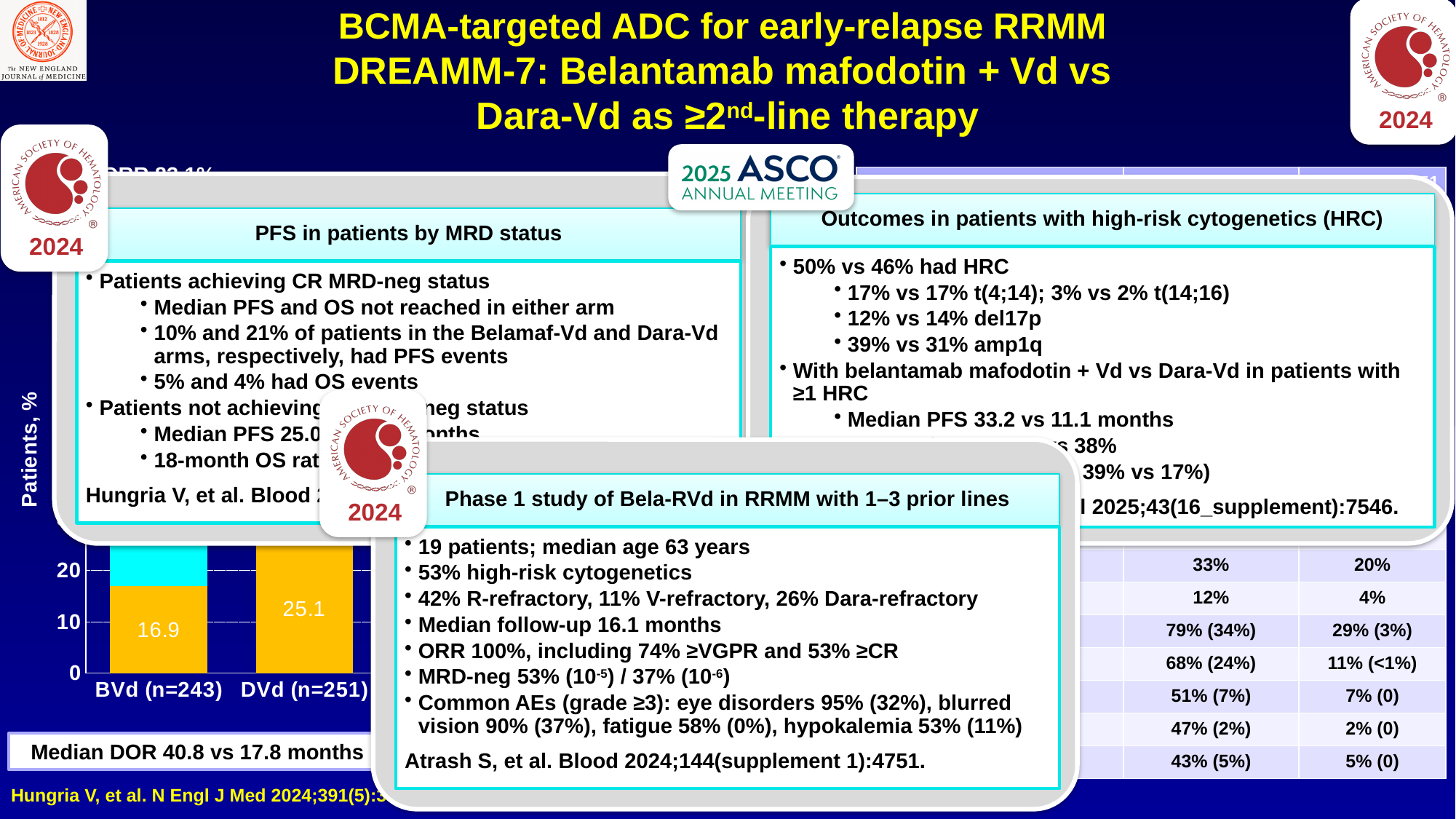
In the bar chart at the bottom left, what value is labelled on the yellow segment of the BVd (n=243) bar? 16.9 How many category bars are visible in the bar chart at the bottom left of the slide? 2 In the bar chart at the bottom left, is the labelled yellow segment value for BVd (n=243) greater or less than 10? greater In the bar chart at the bottom left, what value is labelled on the yellow segment of the DVd (n=251) bar? 25.1 What is the y-axis label of the bar chart at the bottom left of the slide? Patients, % What type of chart is shown at the bottom left of the slide? bar chart In the bar chart at the bottom left, which bar has the larger labelled yellow segment, BVd (n=243) or DVd (n=251)? DVd (n=251) In the bar chart at the bottom left, what is the sample size shown in the label of the DVd bar? n=251 In the bar chart at the bottom left, what is the difference between the labelled yellow segment values of DVd (n=251) and BVd (n=243)? 8.2